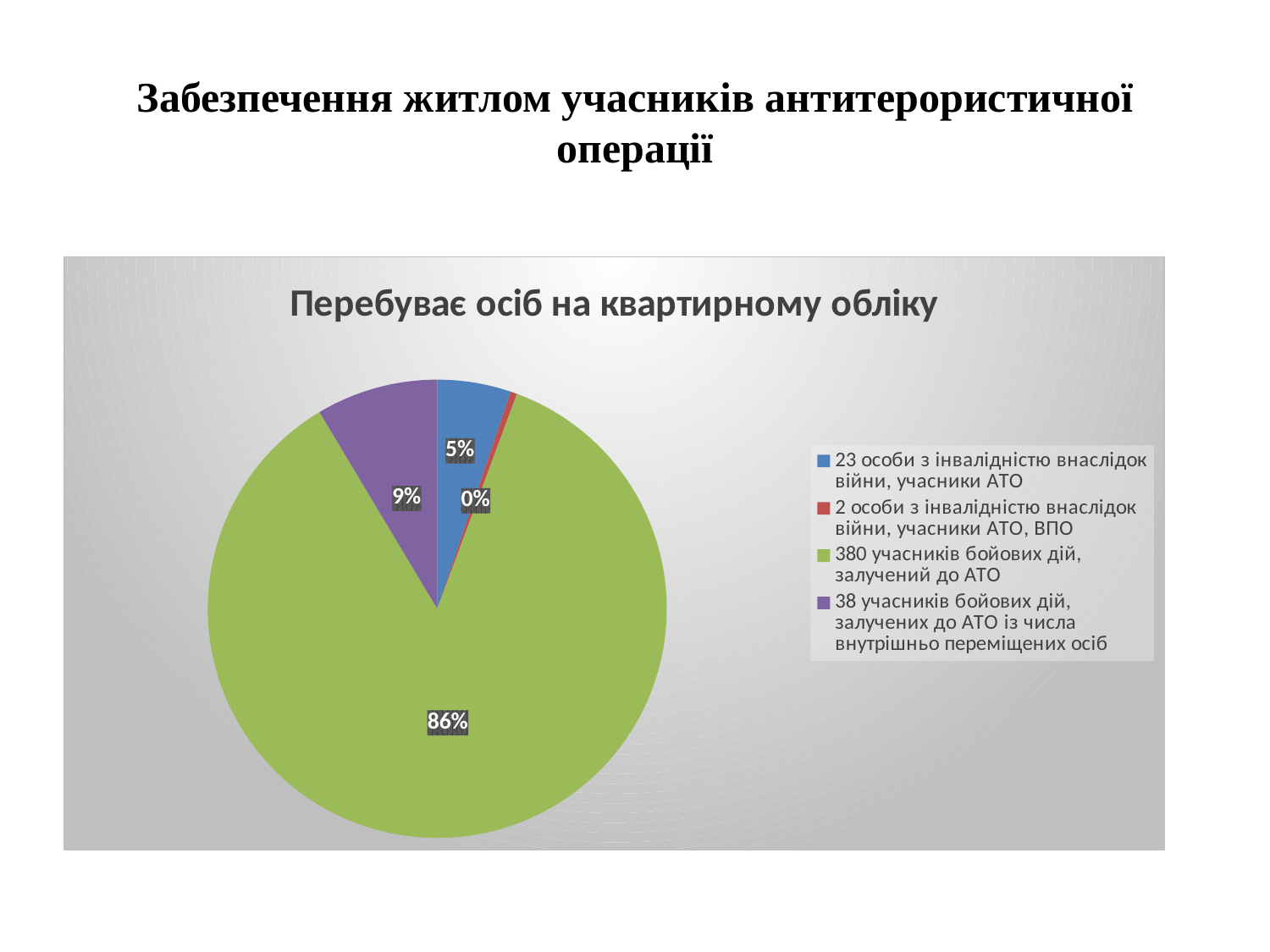
How many slices does the pie chart have? 4 Which category has the largest slice of the pie? 380 учасників бойових дій, залучений до АТО What share of the pie is labelled for '380 учасників бойових дій, залучений до АТО'? 86% What is the difference between the share for '380 учасників бойових дій, залучений до АТО' and the share for '38 учасників бойових дій, залучених до АТО із числа внутрішньо переміщених осіб'? 77 percentage points What share of the pie is labelled for '38 учасників бойових дій, залучених до АТО із числа внутрішньо переміщених осіб'? 9% What kind of chart is shown on the slide? Pie chart What is the title of the chart? Перебуває осіб на квартирному обліку Which slice is larger: '38 учасників бойових дій, залучених до АТО із числа внутрішньо переміщених осіб' or '23 особи з інвалідністю внаслідок війни, учасники АТО'? 38 учасників бойових дій, залучених до АТО із числа внутрішньо переміщених осіб Which category has the smallest slice of the pie? 2 особи з інвалідністю внаслідок війни, учасники АТО, ВПО How many entries does the legend list? 4 What share of the pie is labelled for '23 особи з інвалідністю внаслідок війни, учасники АТО'? 5% What share of the pie is labelled for '2 особи з інвалідністю внаслідок війни, учасники АТО, ВПО'? 0%